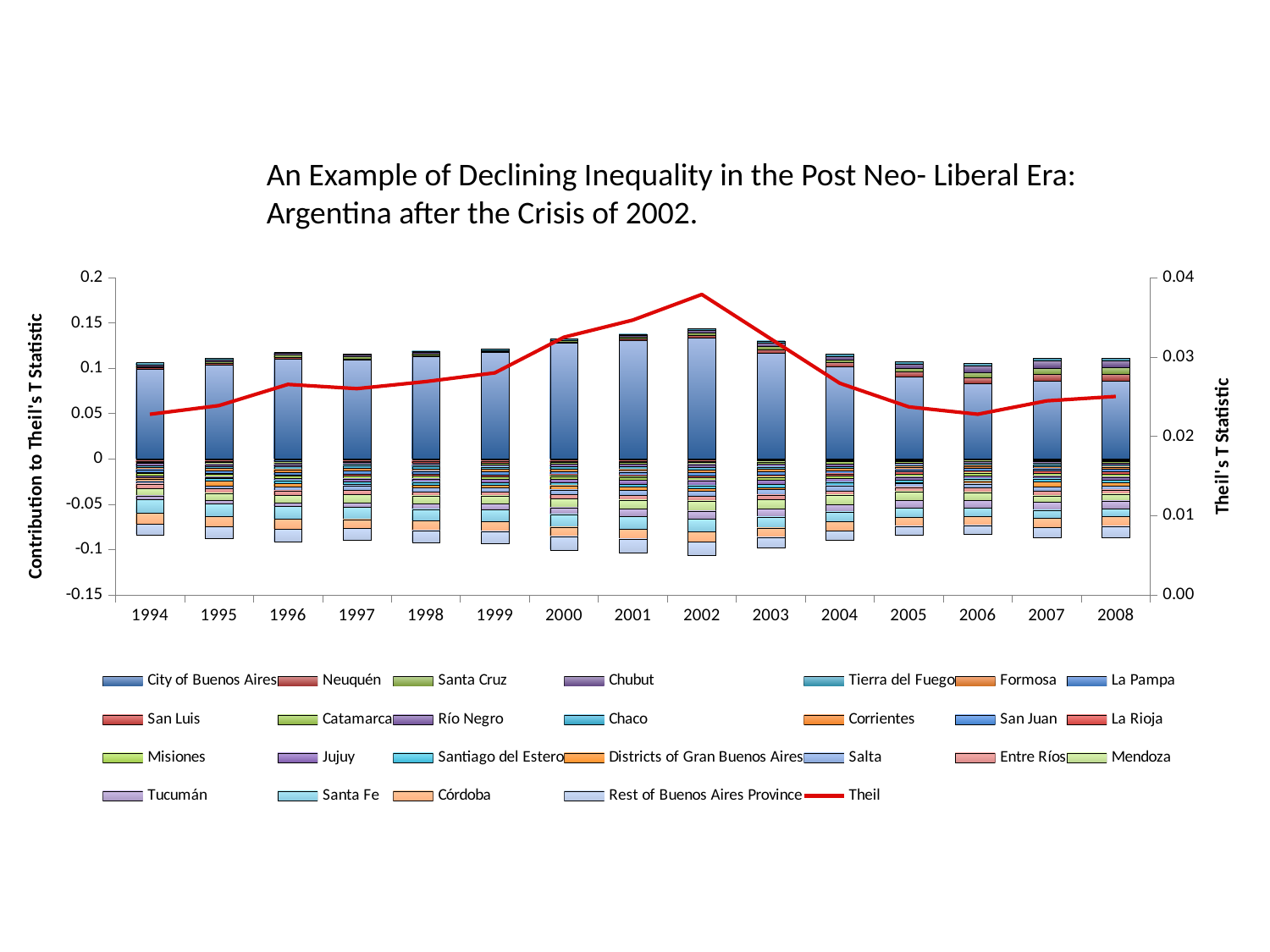
Does the Theil line rise or fall between 1994 and 2002? rise Does the Theil line rise or fall between 2002 and 2006? fall Is the top of the positive stacked bar for 2002 greater or less than 0.1 on the left-hand axis? greater How many entries does the chart's legend list? 26 What kind of chart is shown on the slide? A stacked bar chart combined with a line What is the title of the left-hand vertical axis? Contribution to Theil's T Statistic Which year has the larger Theil line value, 2002 or 2005? 2002 Is the Theil line value for 1994 greater or less than 0.03 on the right-hand axis? less Is the Theil line value for 2002 greater or less than 0.03 on the right-hand axis? greater In which year does the Theil line reach its highest value? 2002 How many years are shown along the x axis of the chart? 15 What is the title of the chart on the slide? An Example of Declining Inequality in the Post Neo- Liberal Era: Argentina after the Crisis of 2002.